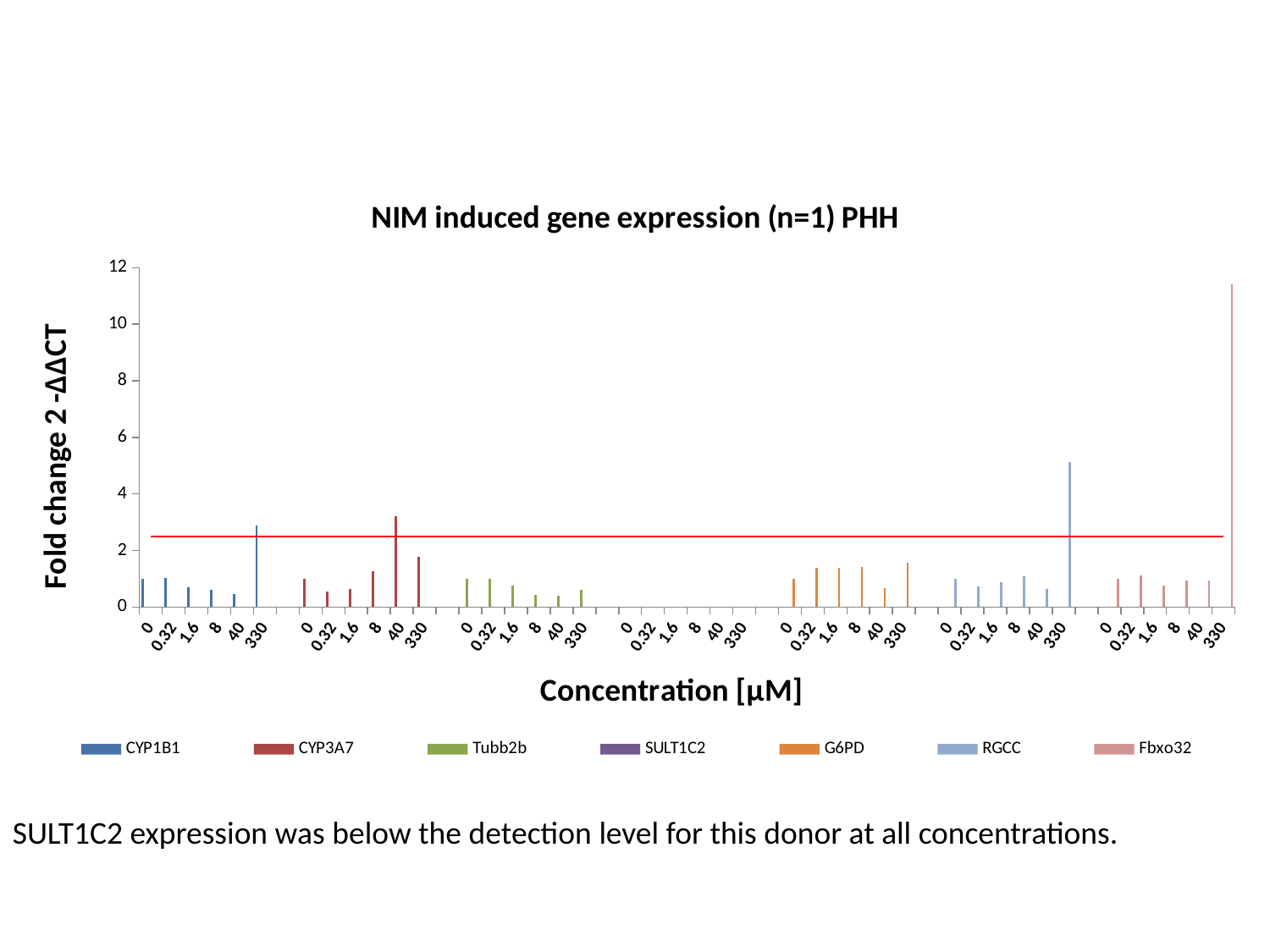
What kind of chart is shown on the slide? Bar chart Which is larger: the value for RGCC at 330 μM or the value for CYP3A7 at 40 μM? RGCC at 330 μM Is the value for Fbxo32 at 330 μM greater or less than 10? greater What is the label of the x axis? Concentration [μM] Which is larger: the value for Fbxo32 at 330 μM or the value for RGCC at 330 μM? Fbxo32 at 330 μM How many concentration levels are shown on the x axis for each series? 6 Is the value for RGCC at 330 μM greater or less than 4? greater Is the value for CYP3A7 at 40 μM greater or less than 2? greater Which series has the tallest bar in the chart? Fbxo32 How many series does the legend list? 7 What is the title of the chart? NIM induced gene expression (n=1) PHH